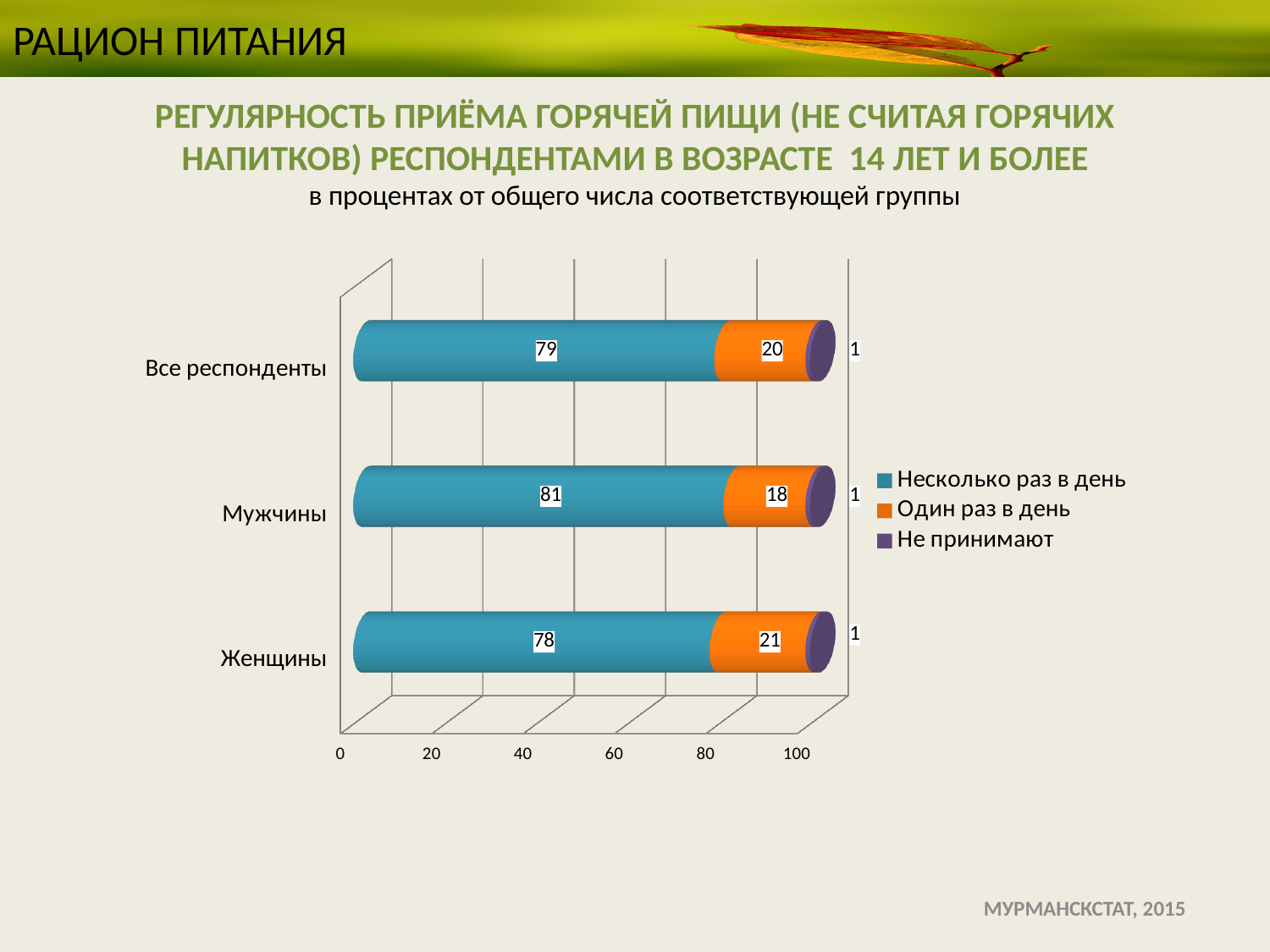
How many series does the legend list? 3 What kind of chart is shown on the slide? Stacked bar chart Which category has the highest value for "Несколько раз в день"? Мужчины What is the total of the stacked bar for "Все респонденты"? 100 What is the difference between the "Один раз в день" values for "Женщины" and "Мужчины"? 3 What value is shown for "Один раз в день" for "Мужчины"? 18 What value is shown for "Не принимают" for "Женщины"? 1 Which category has the lowest value for "Один раз в день"? Мужчины How many categories are shown on the vertical axis? 3 Which is larger: the "Несколько раз в день" value for "Мужчины" or for "Женщины"? Мужчины What value is shown for "Несколько раз в день" for "Все респонденты"? 79 Which legend entry is shown in orange? Один раз в день